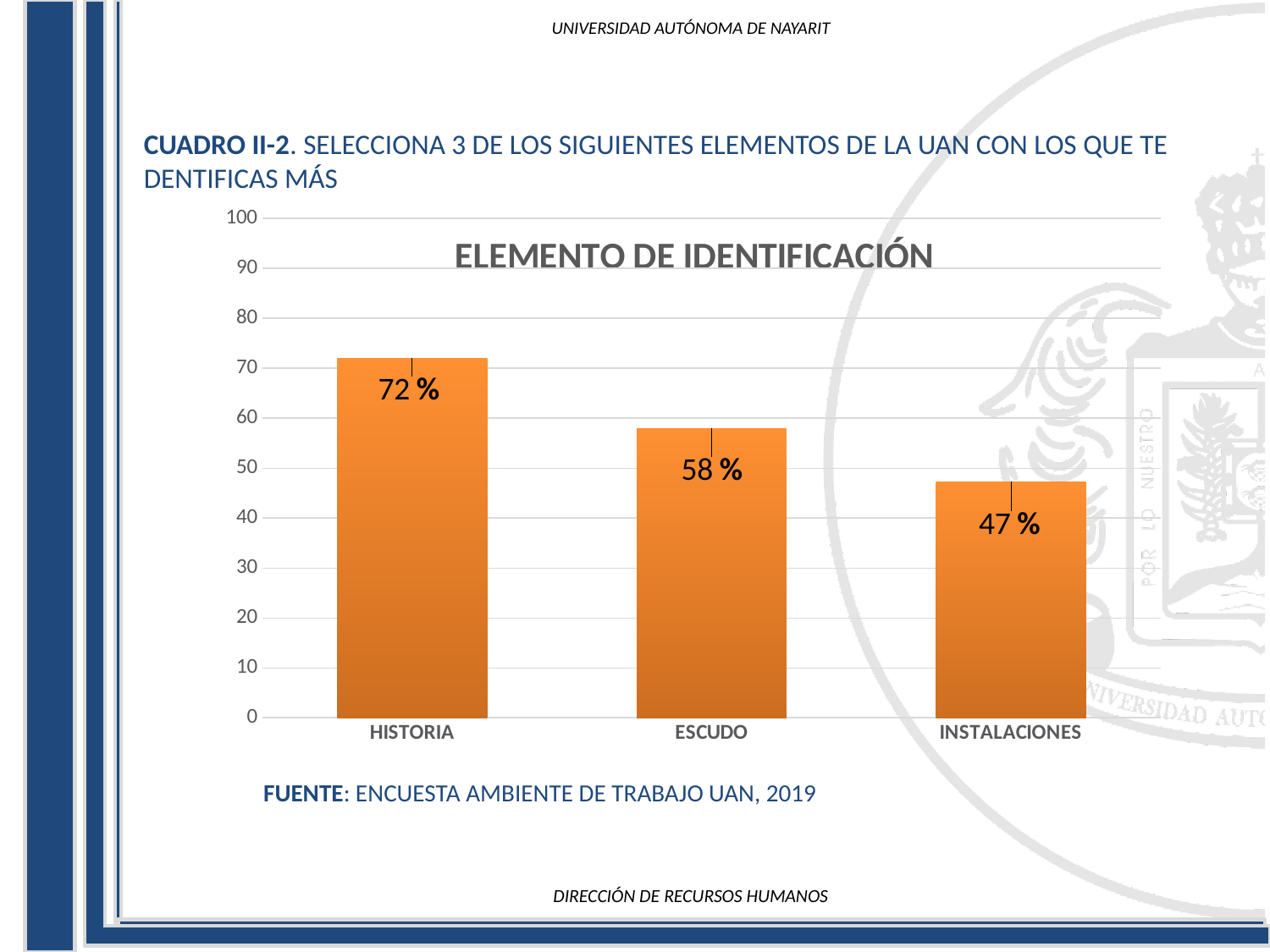
What is the title of the chart? ELEMENTO DE IDENTIFICACIÓN What is the difference between the values for HISTORIA and ESCUDO? 14 % What is the value for HISTORIA? 72 % What kind of chart is shown on the slide? bar chart Which is larger, the value for ESCUDO or the value for INSTALACIONES? ESCUDO How many categories are shown on the x axis? 3 What is the value for ESCUDO? 58 % Which category has the lowest value? INSTALACIONES Which category has the highest value? HISTORIA Is the value for INSTALACIONES greater or less than 50? less What is the value for INSTALACIONES? 47 % What is the difference between the values for ESCUDO and INSTALACIONES? 11 %